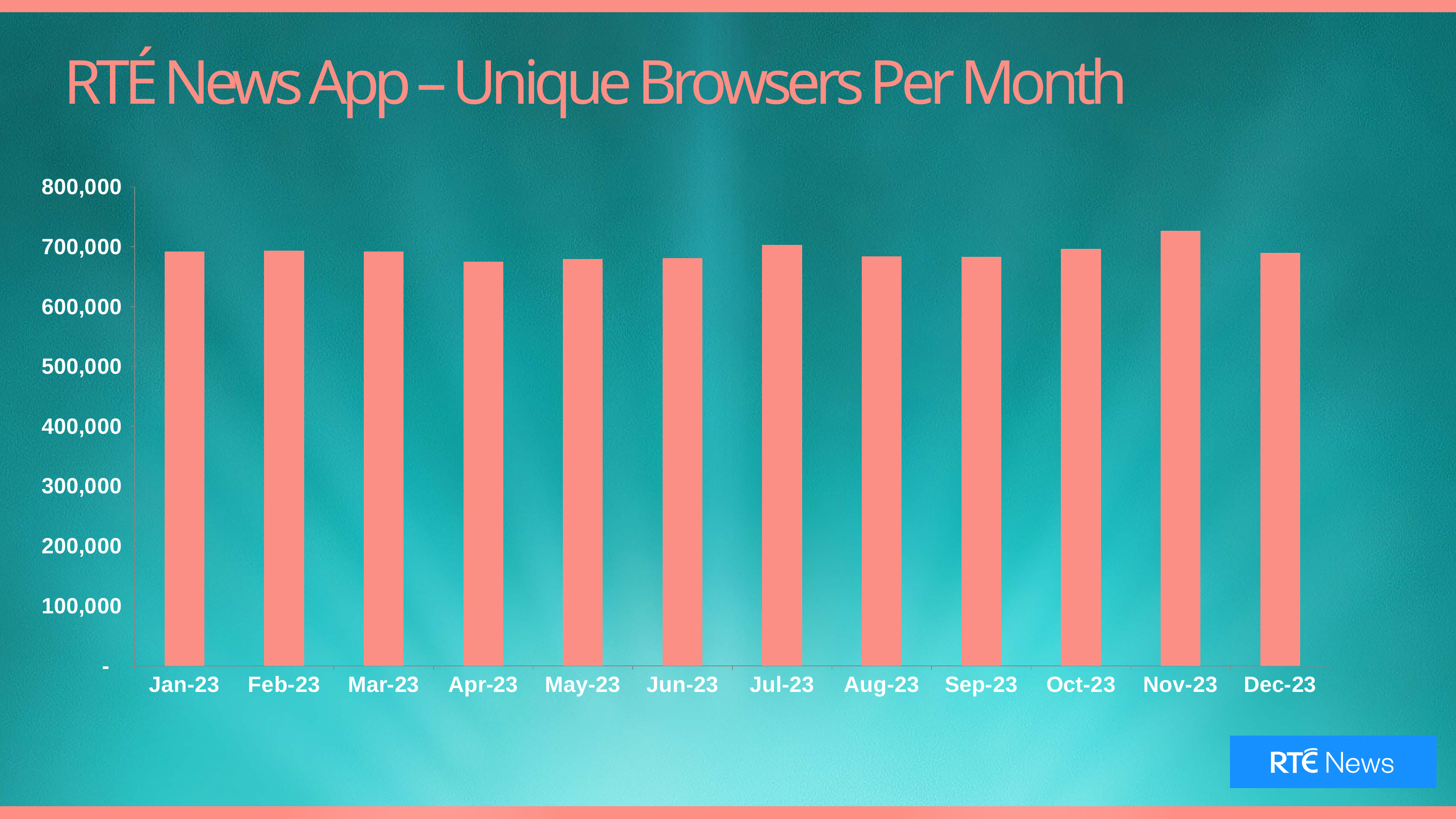
Is the value for Sep-23 greater or less than 700,000? less What is the highest value shown on the vertical axis? 800,000 Which is larger, the value for Jul-23 or the value for Apr-23? Jul-23 Is the value for May-23 greater or less than 600,000? greater Is the value for Apr-23 greater or less than 700,000? less Which is larger, the value for Nov-23 or the value for Apr-23? Nov-23 Which month has the highest number of unique browsers? Nov-23 How many months are plotted on the chart? 12 What is the title of the chart? RTÉ News App – Unique Browsers Per Month Which is larger, the value for Nov-23 or the value for Jul-23? Nov-23 What kind of chart is shown on the slide? bar chart